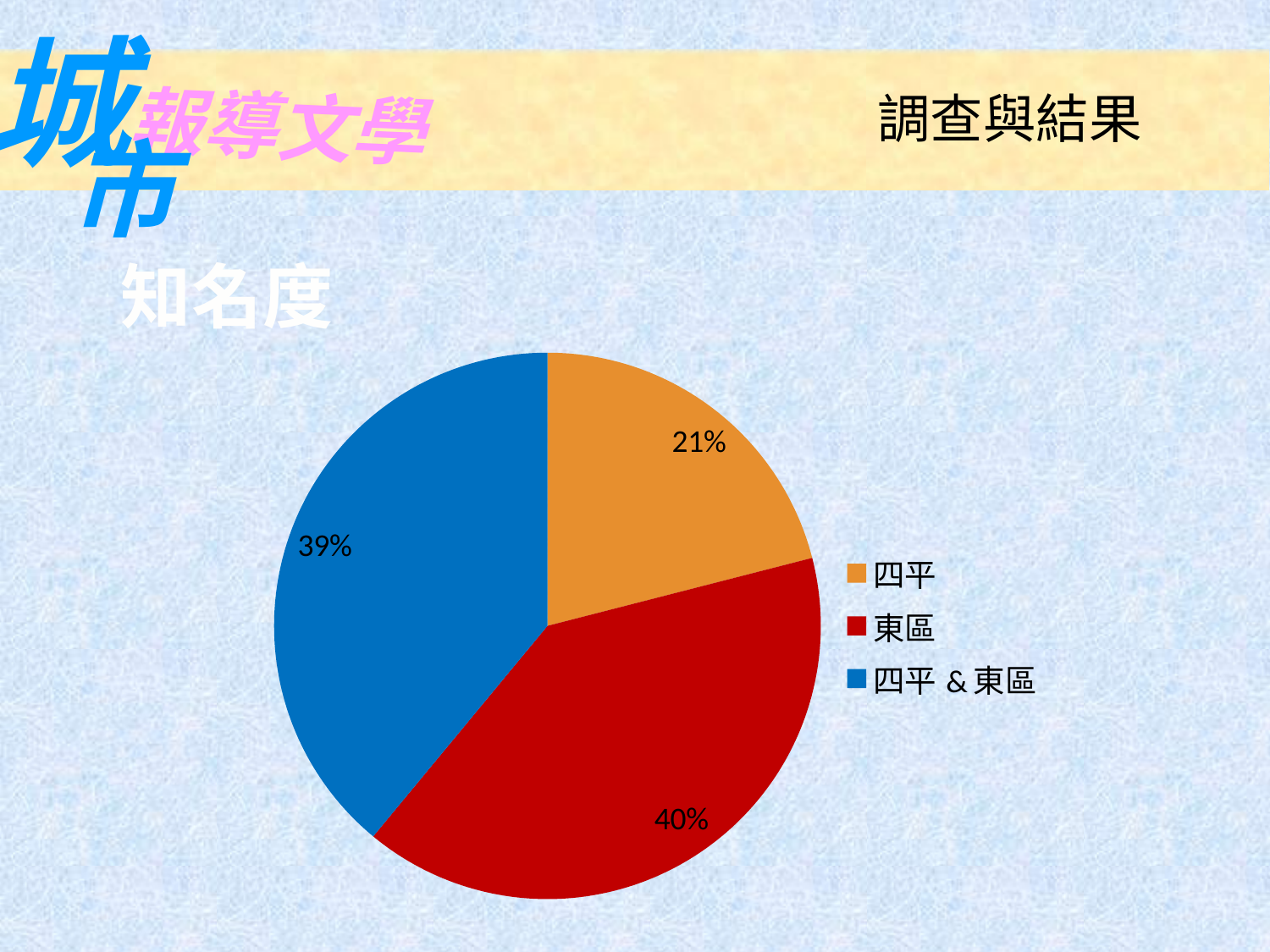
Which is larger, the slice for 四平 or the slice for 四平 & 東區? 四平 & 東區 How many categories does the pie chart have? 3 What colour is the slice for 東區? red What share of the pie does 四平 have? 21% Which category has the smallest slice of the pie? 四平 What is the difference in percentage points between 四平 & 東區 and 四平? 18 Which category has the largest slice of the pie? 東區 What share of the pie does 四平 & 東區 have? 39% What kind of chart is shown on the slide? pie chart What share of the pie does 東區 have? 40% What is the heading above the pie chart? 知名度 What is the difference in percentage points between 東區 and 四平? 19